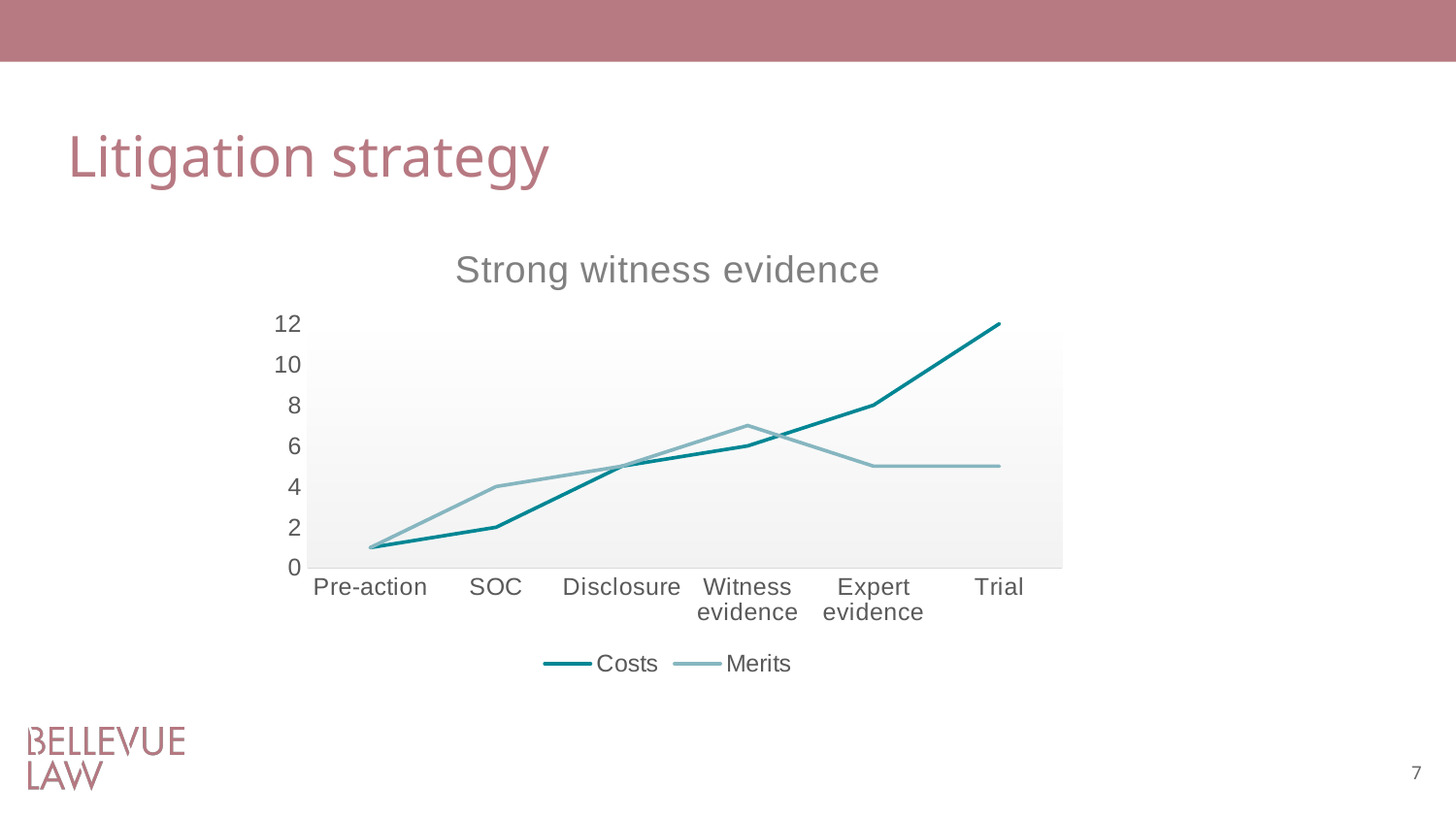
Is the Merits value at Trial greater or less than 6? less What is the Costs value at Trial? 12 At Trial, which series has the larger value, Costs or Merits? Costs How many categories are shown on the x axis? 6 What type of chart is shown on the slide? Line chart What is the Merits value at SOC? 4 At which stage is the Merits series highest? Witness evidence What is the Costs value at Expert evidence? 8 At which stage is the Costs series highest? Trial What is the title of the chart? Strong witness evidence How many series does the legend list? 2 Does the Costs series rise or fall from Pre-action to Trial? Rise